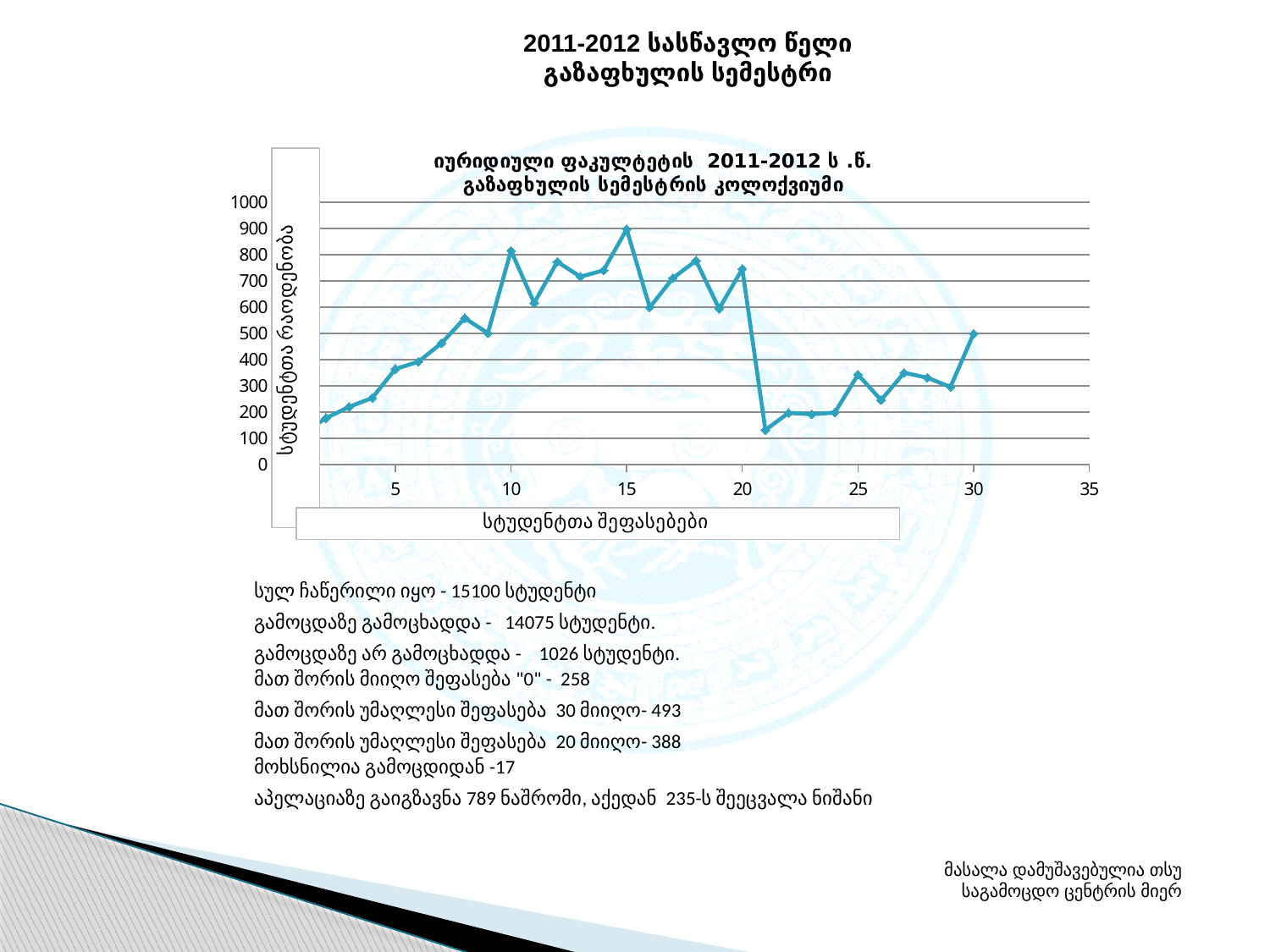
Is the value at score 25 greater or less than 400? less At which score on the x axis does the line reach its highest value? 15 Is the value at score 30 greater or less than 400? greater At which score on the x axis does the line reach its lowest value? 21 Which has the higher value: score 15 or score 30? 15 What is the title of the y axis? სტუდენტთა რაოდენობა Is the value at score 21 greater or less than 200? less Which has the higher value: score 10 or score 25? 10 What kind of chart is shown on the slide? line chart Between score 20 and score 21, does the line rise or fall? fall